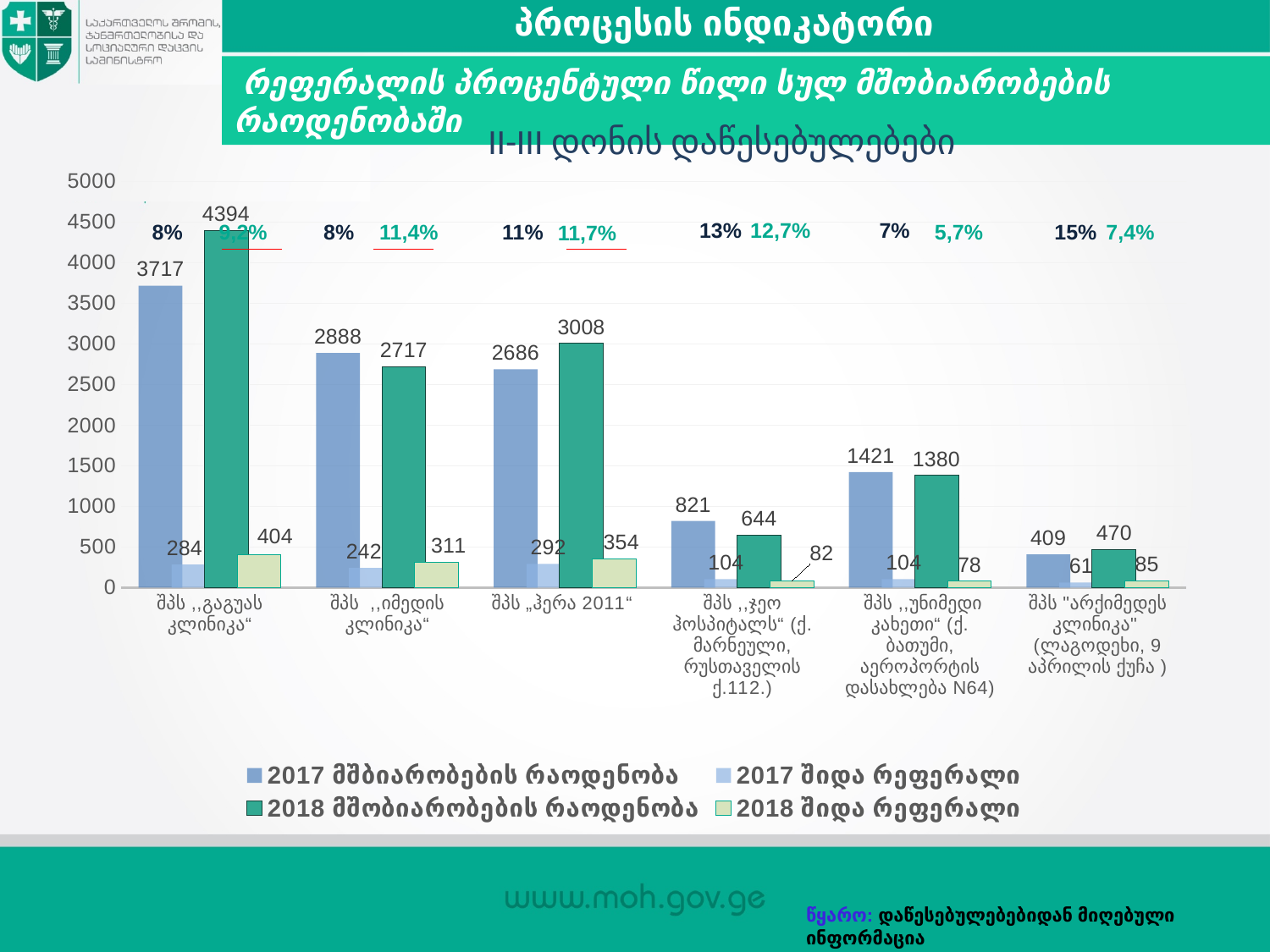
What is the 2018 referral percentage shown above the bars for შპს „ჯეო ჰოსპიტალს“? 12,7% What is the 2018 number of births (2018 მშობიარობების რაოდენობა) for შპს „გაგუას კლინიკა“? 4394 Which facility has the lowest 2017 number of births? შპს „არქიმედეს კლინიკა“ How many facilities (categories) are shown on the x axis? 6 Which facility has the highest 2018 number of births? შპს „გაგუას კლინიკა“ What is the 2018 internal referral value (2018 შიდა რეფერალი) for შპს „იმედის კლინიკა“? 311 For შპს „უნიმედი კახეთი“, which is larger: the 2017 number of births or the 2018 number of births? 2017 number of births (1421) What kind of chart is shown on the slide? Bar chart How many series does the legend list? 4 What is the difference between the 2018 and 2017 number of births for შპს „პერა 2011“? 322 What is the title printed directly above the chart? II-III დონის დაწესებულებები What is the 2017 number of births (2017 მშბიარობების რაოდენობა) for შპს „პერა 2011“? 2686